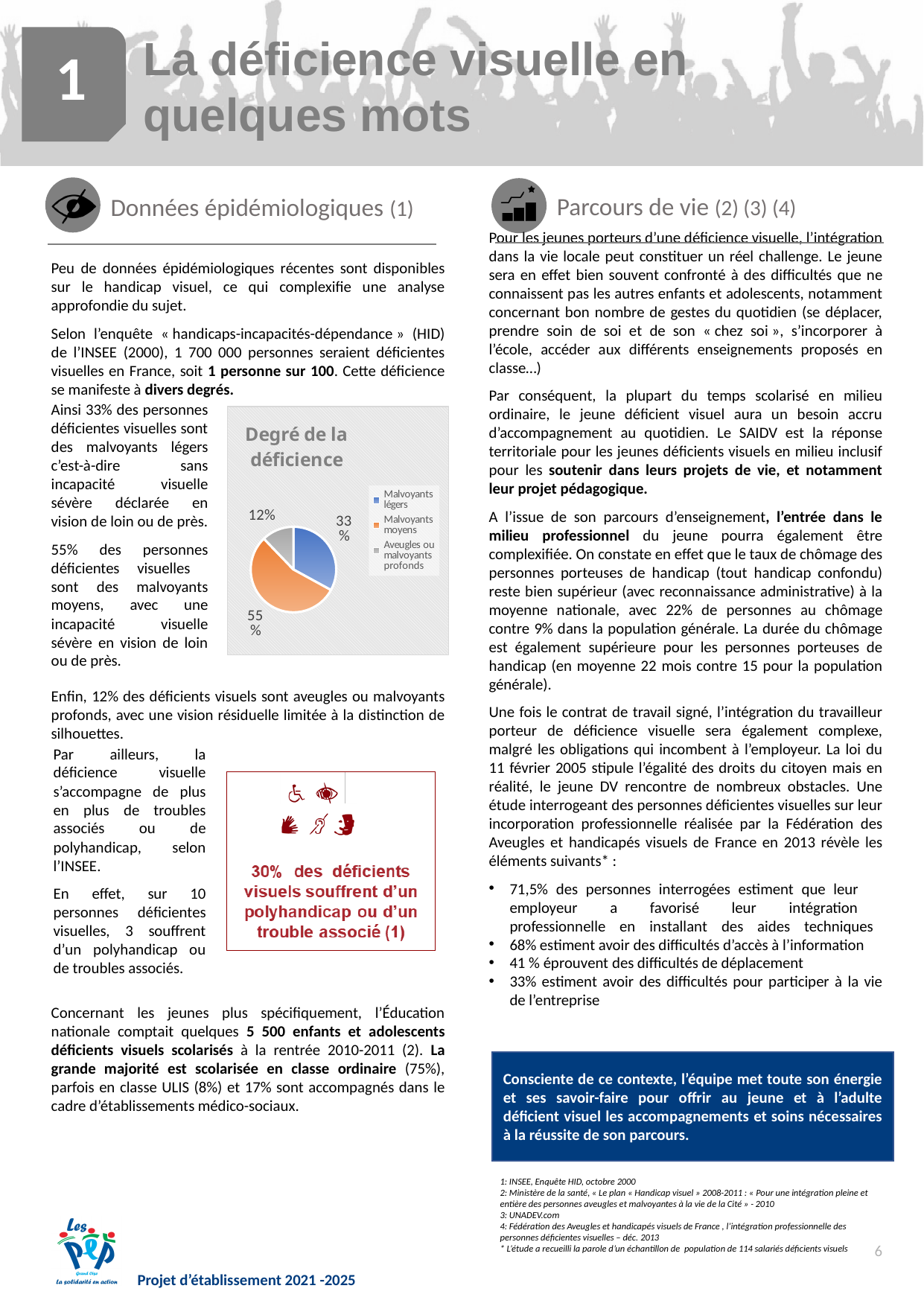
In the "Degré de la déficience" chart, what is the difference between the shares for Malvoyants moyens and Malvoyants légers? 22% In the "Degré de la déficience" chart, what share is shown for Malvoyants moyens? 55% What type of chart is "Degré de la déficience"? pie chart How many entries does the legend of the "Degré de la déficience" chart list? 3 Which category has the largest slice in the "Degré de la déficience" chart? Malvoyants moyens In the "Degré de la déficience" chart, what colour is the Malvoyants moyens slice? orange Which category has the smallest slice in the "Degré de la déficience" chart? Aveugles ou malvoyants profonds In the "Degré de la déficience" chart, what share is shown for Aveugles ou malvoyants profonds? 12% In the "Degré de la déficience" chart, what share is shown for Malvoyants légers? 33% What is the title of the chart on the slide? Degré de la déficience In the "Degré de la déficience" chart, which is larger: Malvoyants légers or Aveugles ou malvoyants profonds? Malvoyants légers How many categories does the "Degré de la déficience" pie chart show? 3